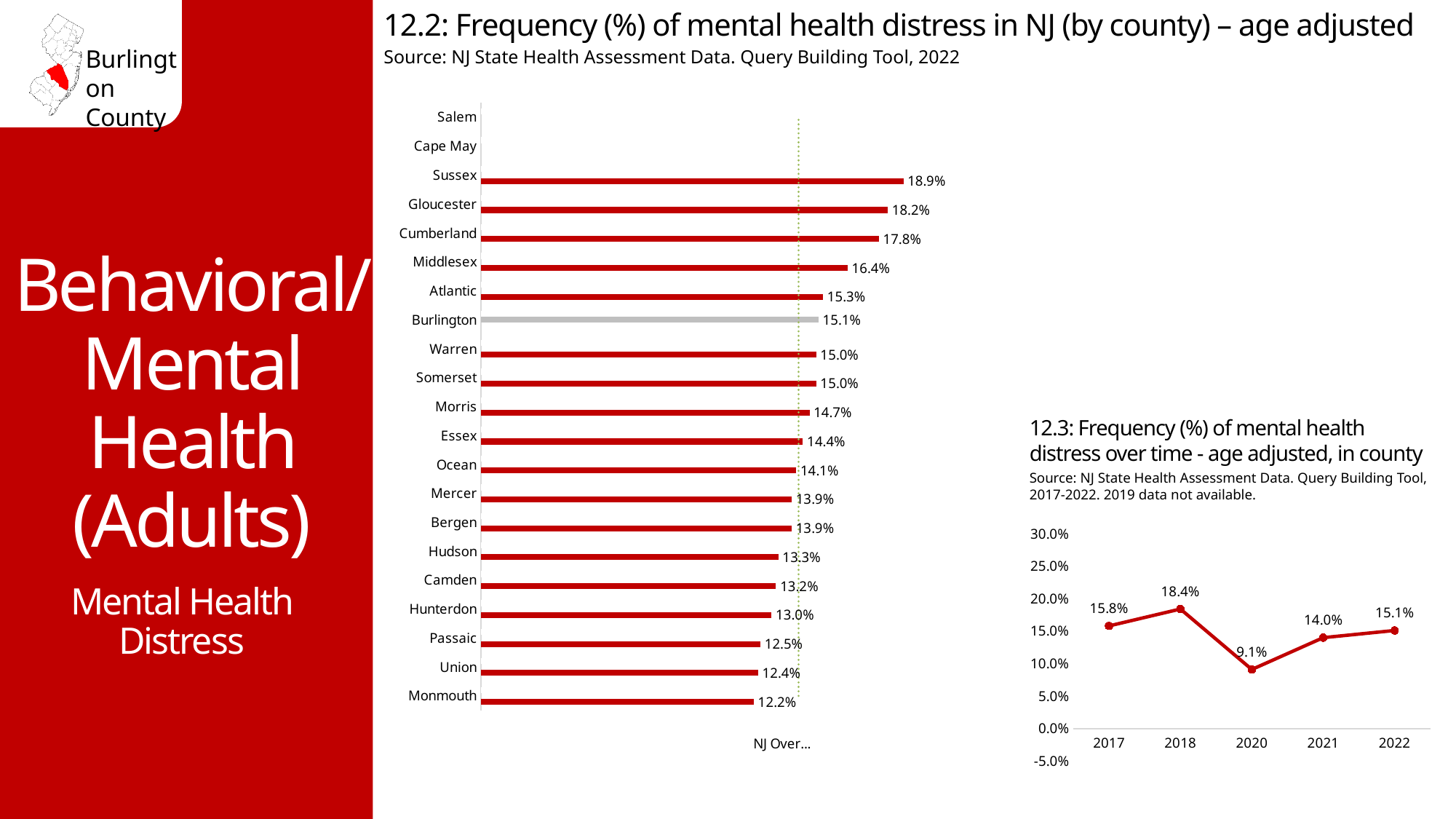
What kind of chart is chart 12.2? Bar chart In chart 12.3, what is the frequency of mental health distress in 2020? 9.1% In chart 12.2, what is the frequency of mental health distress for Burlington County? 15.1% In chart 12.2, which county with a plotted bar has the lowest frequency of mental health distress? Monmouth In chart 12.2, which county has the highest frequency of mental health distress? Sussex In chart 12.3, do the values rise or fall from 2020 to 2022? Rise How many data points are plotted in chart 12.3? 5 In chart 12.2, what is the value shown for Sussex? 18.9% In chart 12.2, which county has a higher value, Atlantic or Hudson? Atlantic In chart 12.3, which year has the highest value? 2018 In chart 12.2, what is the difference between the values for Gloucester and Burlington? 3.1% In chart 12.3, what is the difference between the 2018 and 2020 values? 9.3%